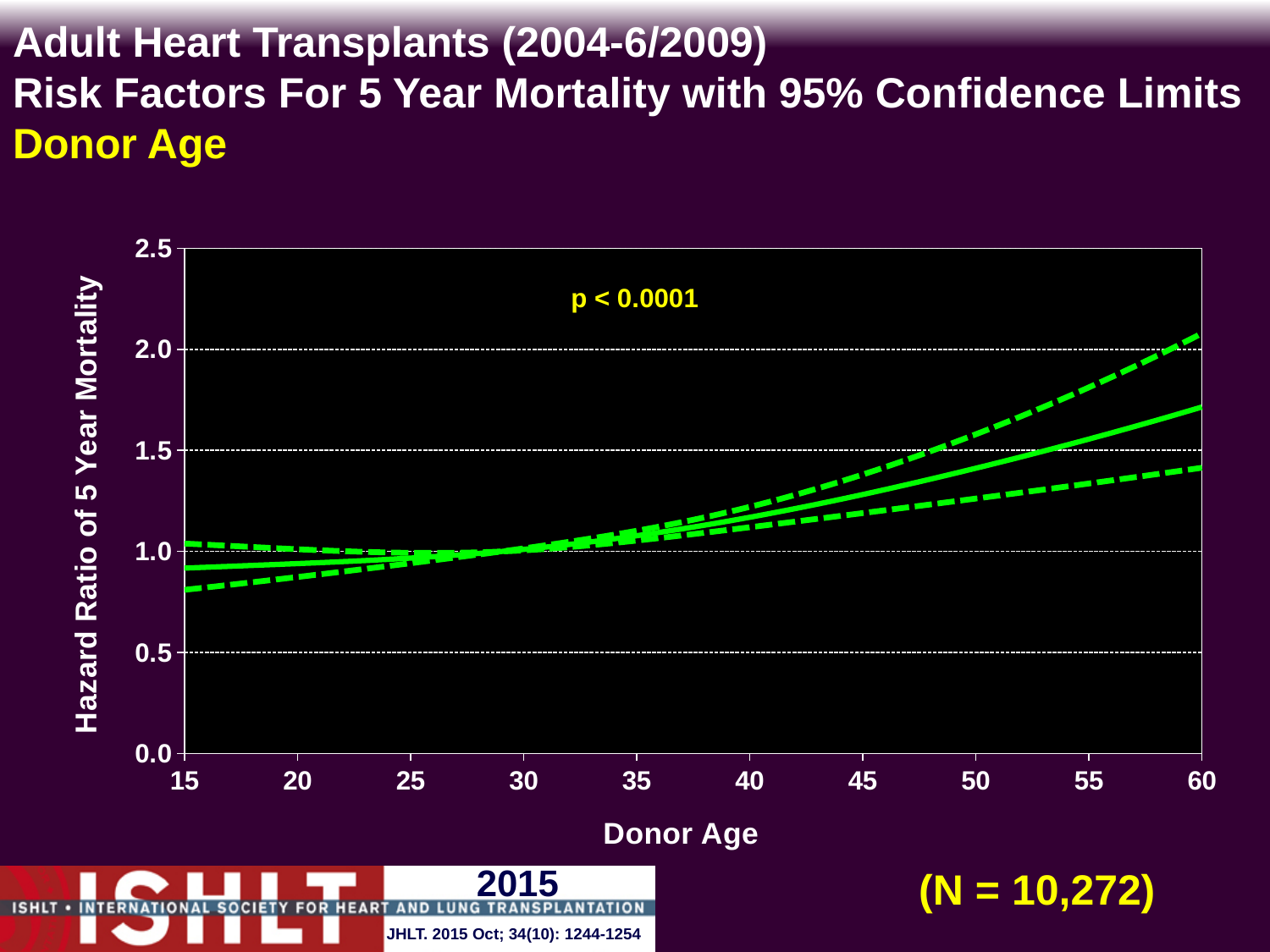
How many lines are plotted on the chart? 3 Is the hazard ratio on the solid line at donor age 15 greater or less than 1.0? less What sample size (N) is shown on the slide? N = 10,272 Is the upper dashed confidence limit at donor age 60 greater or less than 1.5? greater Which is larger at donor age 60: the upper dashed confidence limit or the solid line? the upper dashed confidence limit What kind of chart is shown on the slide? line chart Is the lower dashed confidence limit at donor age 60 greater or less than 1.5? less What p-value is printed on the chart? p < 0.0001 Does the hazard ratio of 5 year mortality rise or fall as donor age increases from 15 to 60? rise